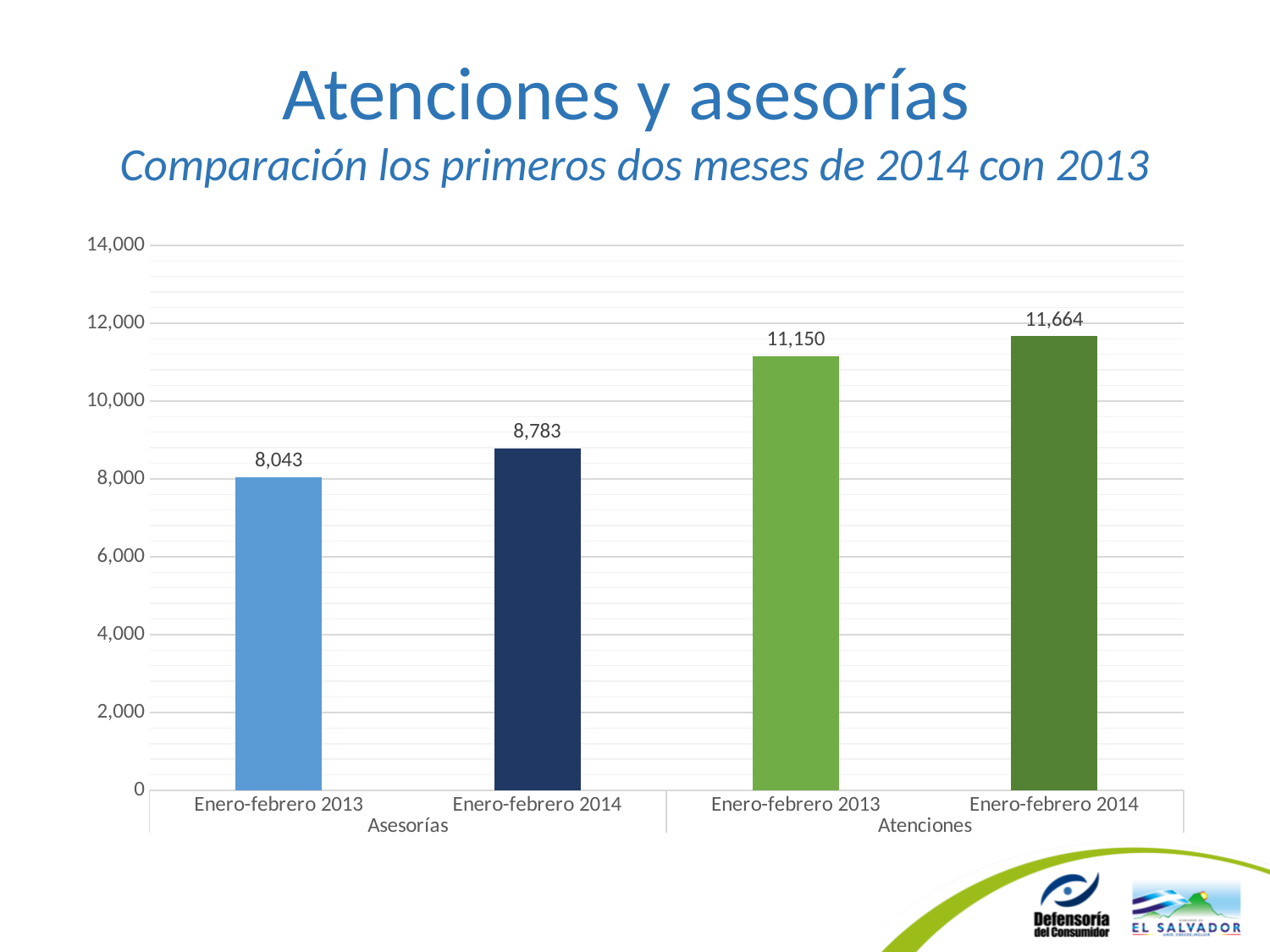
What is the value for Atenciones in Enero-febrero 2014? 11,664 Which bar has the highest value? Atenciones, Enero-febrero 2014 What kind of chart is shown on the slide? Bar chart How many bars are plotted in the chart? 4 What is the value for Atenciones in Enero-febrero 2013? 11,150 Which bar has the lowest value? Asesorías, Enero-febrero 2013 What is the value for Asesorías in Enero-febrero 2014? 8,783 Is the value for Atenciones in Enero-febrero 2013 greater or less than 10,000? greater What is the difference between Asesorías in Enero-febrero 2014 and Enero-febrero 2013? 740 What is the value for Asesorías in Enero-febrero 2013? 8,043 Which is larger: Asesorías in Enero-febrero 2014 or Atenciones in Enero-febrero 2013? Atenciones in Enero-febrero 2013 What is the difference between Atenciones in Enero-febrero 2014 and Enero-febrero 2013? 514